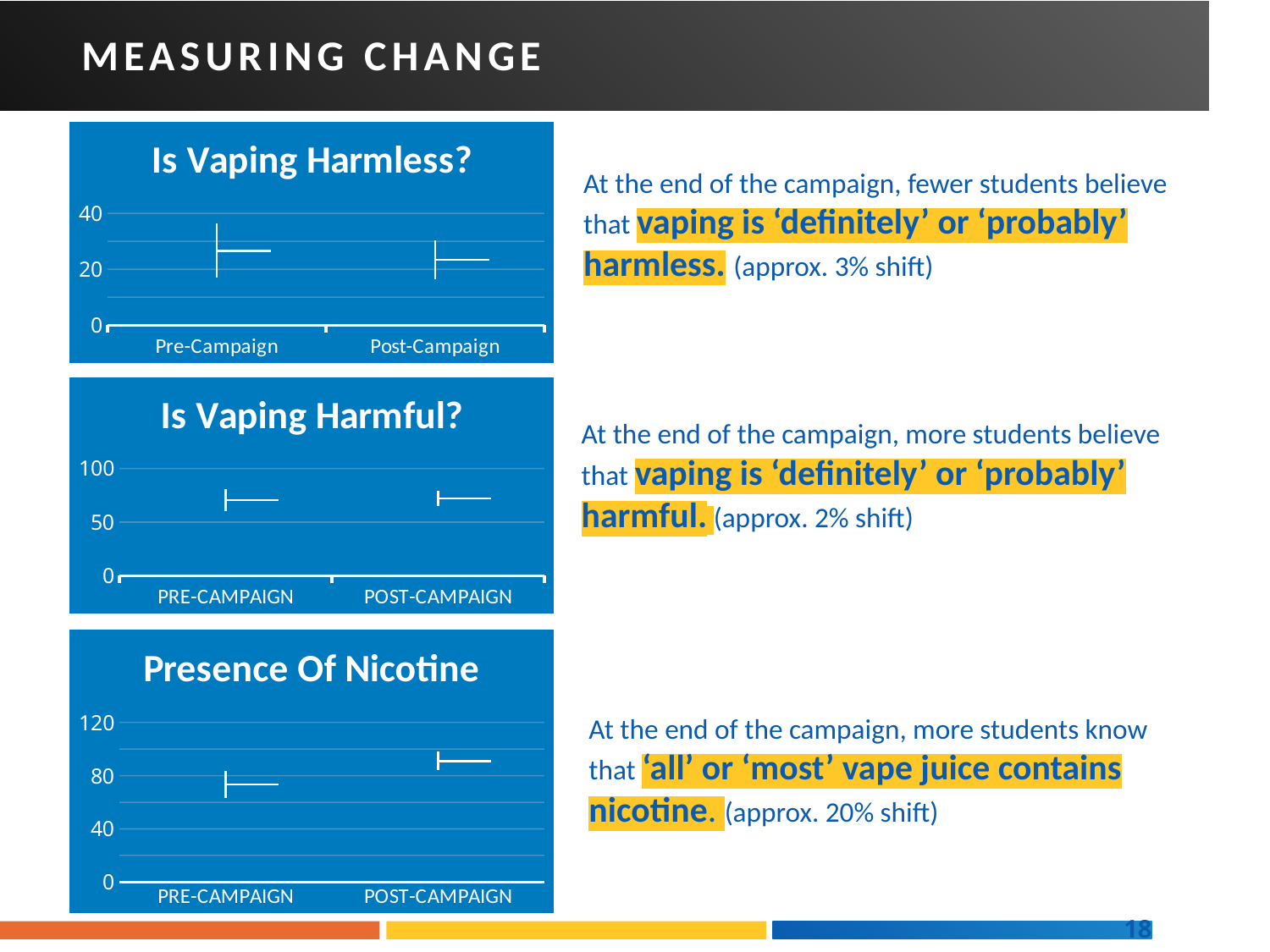
How many categories are shown on the x axis of the 'Is Vaping Harmful?' chart? 2 In the 'Is Vaping Harmless?' chart, is the value for Pre-Campaign greater or less than 40? less In the 'Presence Of Nicotine' chart, which is higher, PRE-CAMPAIGN or POST-CAMPAIGN? POST-CAMPAIGN In the 'Is Vaping Harmless?' chart, which is higher, Pre-Campaign or Post-Campaign? Pre-Campaign What is the highest value labelled on the y axis of the 'Presence Of Nicotine' chart? 120 In the 'Is Vaping Harmful?' chart, is the value for PRE-CAMPAIGN greater or less than 50? greater How many categories are shown on the x axis of the 'Is Vaping Harmless?' chart? 2 In the 'Presence Of Nicotine' chart, do the values rise or fall from PRE-CAMPAIGN to POST-CAMPAIGN? rise In the 'Presence Of Nicotine' chart, is the value for POST-CAMPAIGN greater or less than 80? greater